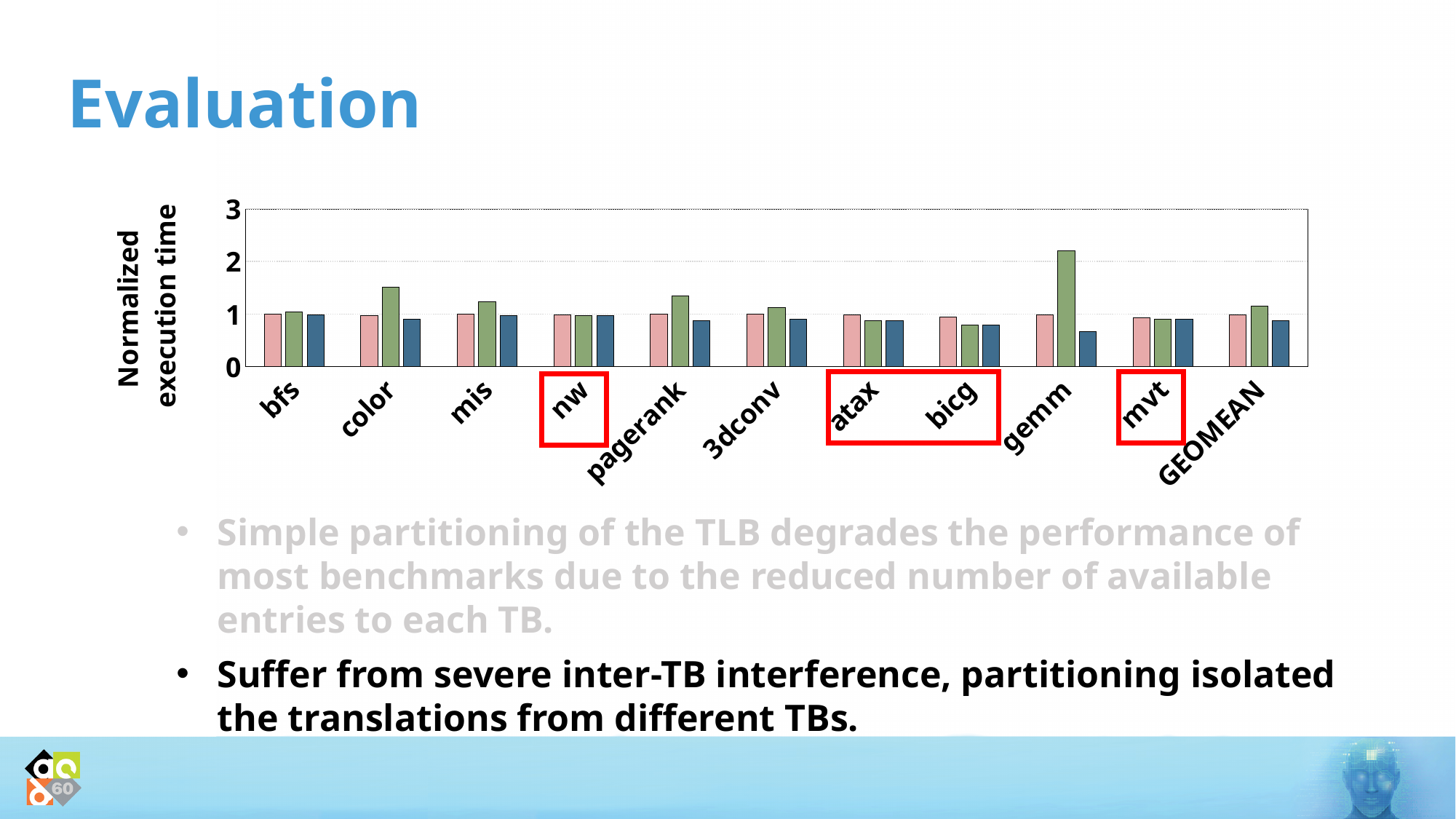
Is the value of the green bar for color greater or less than 1? greater What is the label of the y axis of the chart? Normalized execution time Is the value of the green bar for pagerank greater or less than 2? less What is the highest tick value shown on the y axis of the chart? 3 Which category contains the tallest bar in the chart? gemm How many bars are plotted for each category in the chart? 3 Which is larger for color, the green bar or the pink bar? the green bar Which is larger for gemm, the green bar or the blue bar? the green bar Is the value of the blue bar for gemm greater or less than 1? less What kind of chart is shown on the slide? bar chart How many benchmark categories are shown on the x axis of the chart? 11